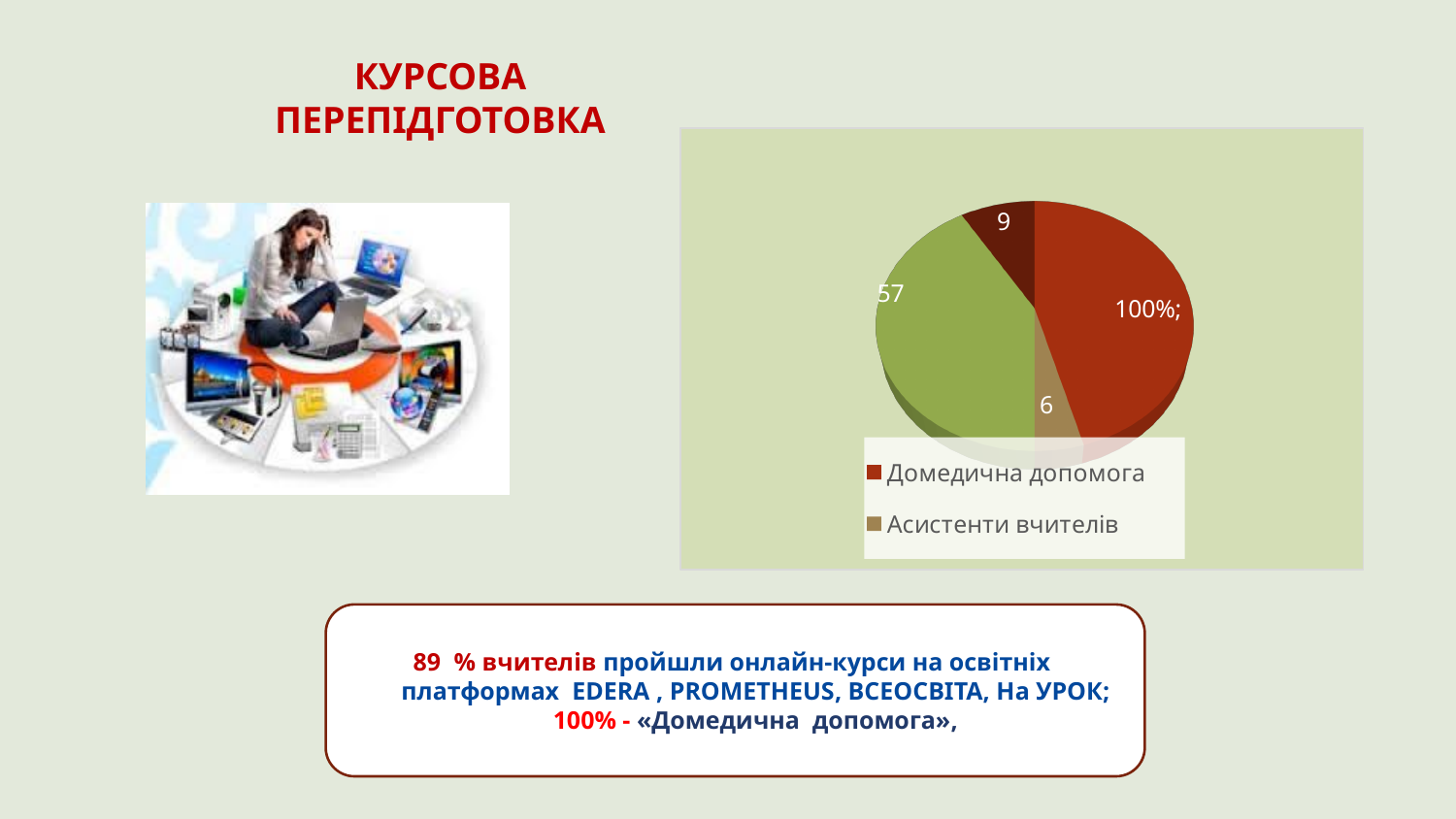
Which slice is larger, «Домедична допомога» or «Асистенти вчителів»? Домедична допомога What value is labelled on the slice for «Асистенти вчителів»? 6 How many slices does the pie chart have? 4 How many entries does the chart legend list? 2 What kind of chart is shown on the slide? pie chart What colour is the slice for «Домедична допомога»? red What is the difference between the slice labelled 9 and the slice labelled 6? 3 What is the smallest value labelled on the pie chart? 6 What value is labelled on the slice for «Домедична допомога»? 100% What is the difference between the slice labelled 57 and the slice labelled 9? 48 What is the first entry listed in the chart legend? Домедична допомога